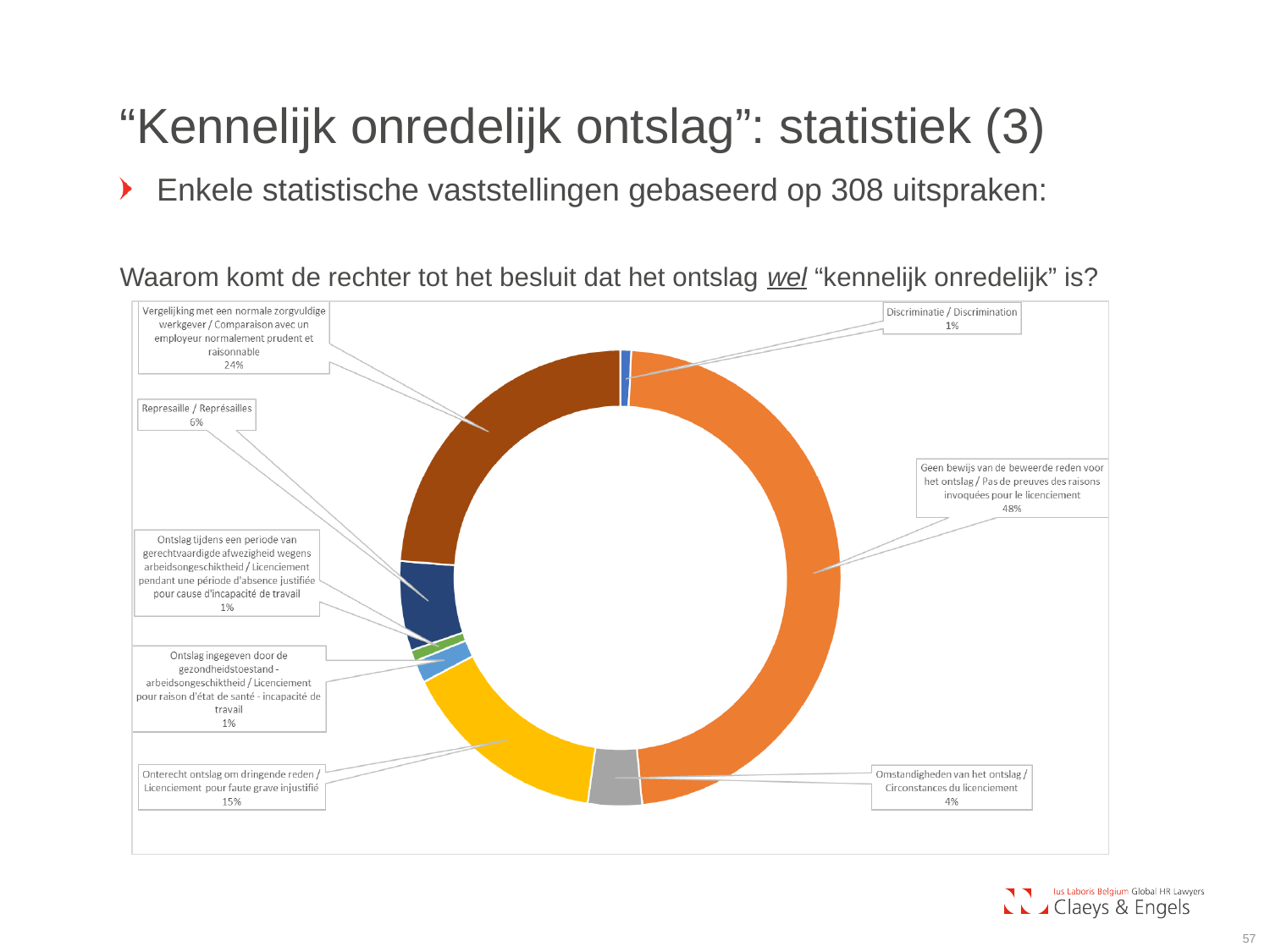
What share of the pie is 'Geen bewijs van de beweerde reden voor het ontslag / Pas de preuves des raisons invoquées pour le licenciement'? 48% What percentage is shown for 'Represaille / Représailles'? 6% What is the difference in percentage points between 'Geen bewijs van de beweerde reden voor het ontslag' (48%) and 'Vergelijking met een normale zorgvuldige werkgever' (24%)? 24 percentage points Which category has the largest share of the pie? Geen bewijs van de beweerde reden voor het ontslag / Pas de preuves des raisons invoquées pour le licenciement How many categories (slices) does the chart show? 8 What kind of chart is shown on the slide? Pie chart (doughnut) What percentage is shown for 'Discriminatie / Discrimination'? 1% Which is larger: the share for 'Represaille / Représailles' or the share for 'Omstandigheden van het ontslag / Circonstances du licenciement'? Represaille / Représailles How many categories on the chart are labelled with 1%? 3 What percentage is shown for 'Onterecht ontslag om dringende reden / Licenciement pour faute grave injustifié'? 15% What percentage is shown for 'Omstandigheden van het ontslag / Circonstances du licenciement'? 4% What percentage is shown for 'Vergelijking met een normale zorgvuldige werkgever / Comparaison avec un employeur normalement prudent et raisonnable'? 24%